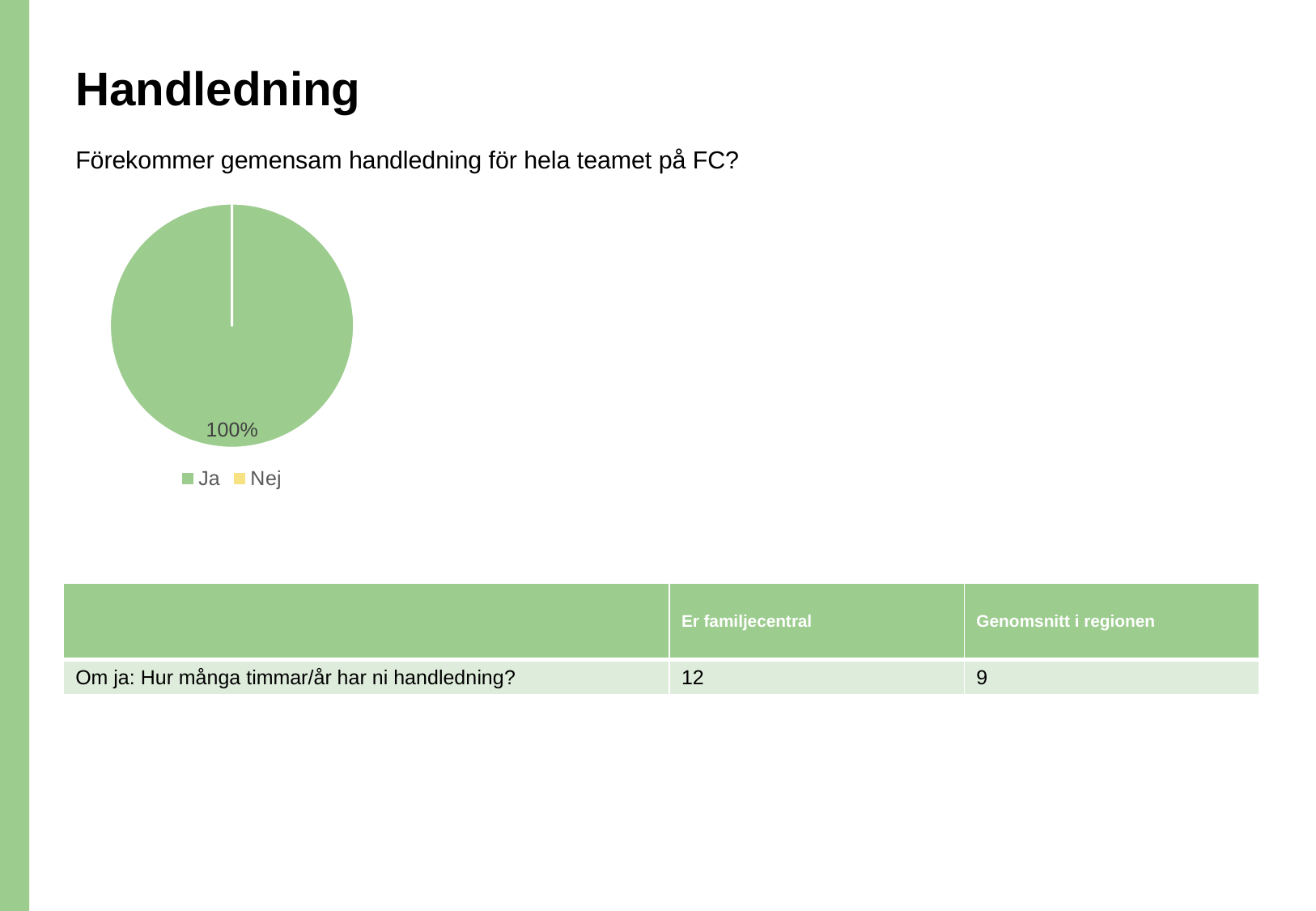
What share of the pie does the Ja slice represent? 100% Which is larger in the pie chart, Ja or Nej? Ja Is the share for Ja greater or less than 50%? greater What are the two legend entries of the pie chart? Ja and Nej Which category has the largest share of the pie? Ja How many entries does the pie chart's legend list? 2 What kind of chart is shown on the slide? pie chart What value is printed on the pie chart? 100% What colour represents Ja in the pie chart? green